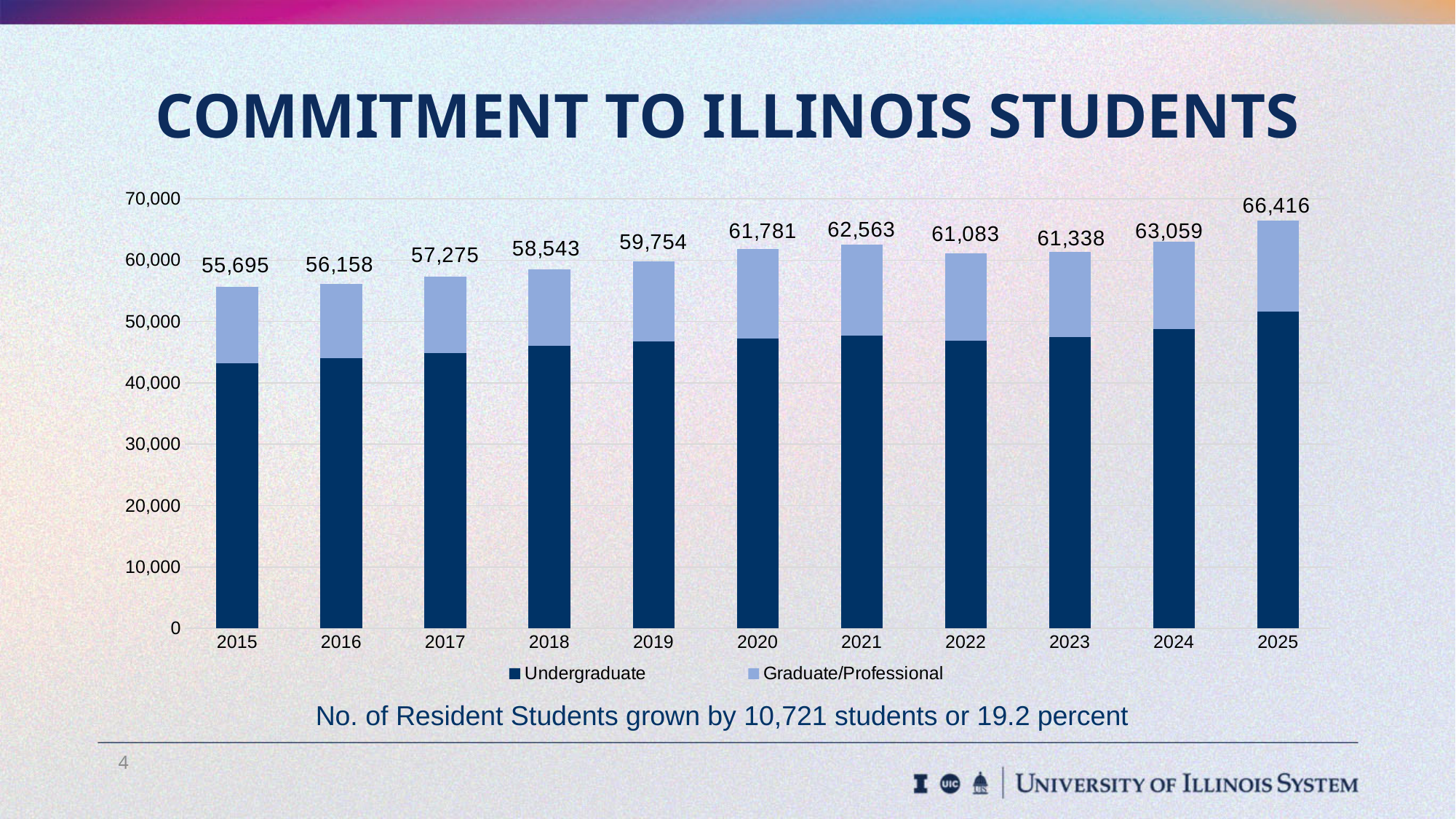
What is the total number of resident students shown for 2020? 61,781 What is the total number of resident students shown for 2015? 55,695 What is the difference between the totals for 2024 and 2023? 1,721 Is the Undergraduate value for 2015 greater or less than 50,000? less What is the total number of resident students shown for 2025? 66,416 Which year has the highest total number of resident students? 2025 By how much did the total number of resident students increase from 2015 to 2025? 10,721 Which year has the lowest total number of resident students? 2015 What kind of chart is shown on the slide? Stacked bar chart How many series does the legend list? 2 How many years are shown on the x axis? 11 Which year has a larger total, 2021 or 2022? 2021